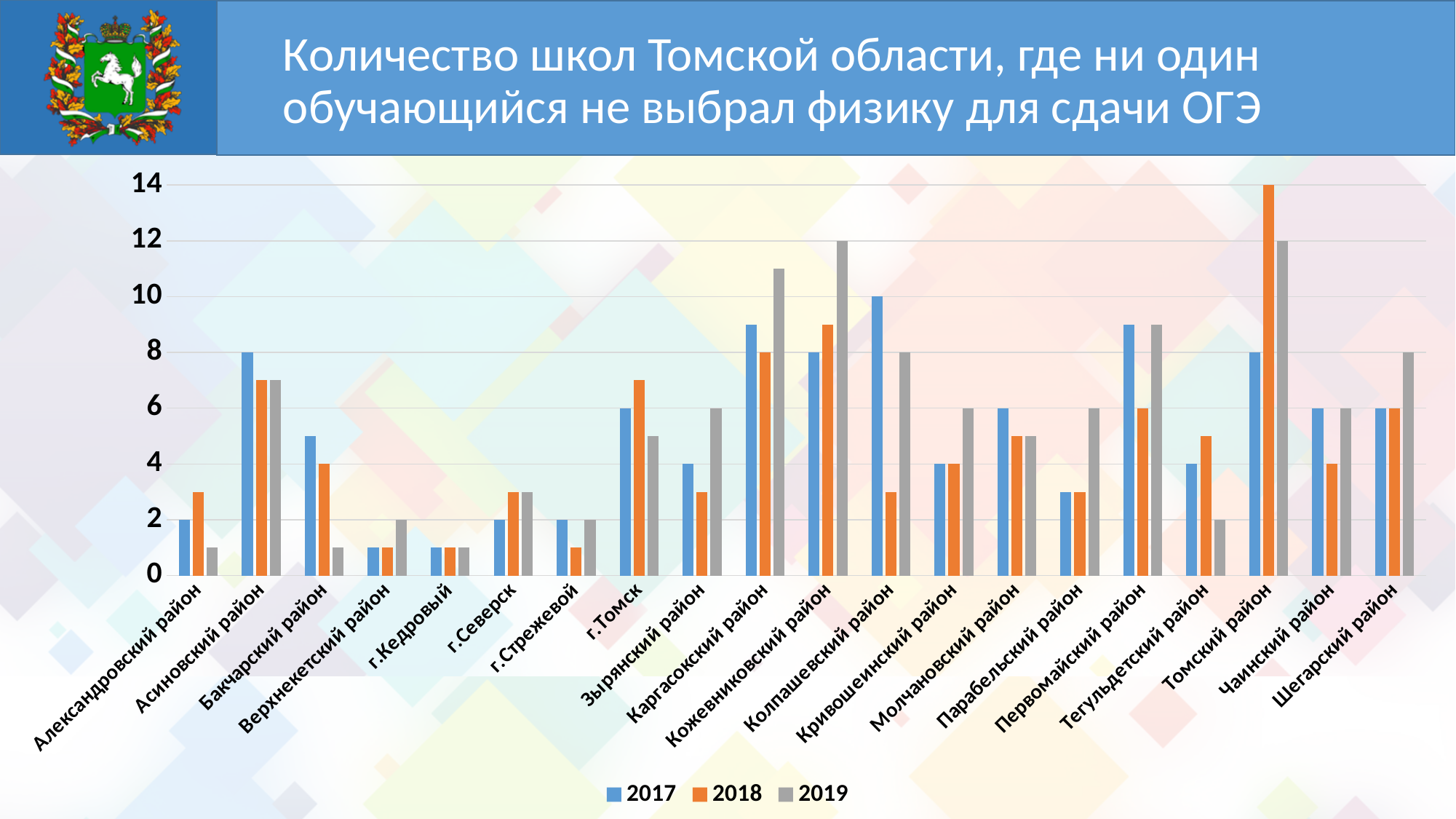
How many districts (categories) are shown on the x axis? 20 What is the value for Томский район in 2018? 14 For Колпашевский район, which year has the larger value, 2017 or 2018? 2017 Do the values for Кожевниковский район rise or fall from 2017 to 2019? rise What kind of chart is shown on the slide? bar chart What are the legend entries of the chart? 2017, 2018, 2019 What is the value for Кожевниковский район in 2019? 12 Which district has the highest value in 2018? Томский район What is the value for Колпашевский район in 2017? 10 What is the difference between the 2018 and 2017 values for Томский район? 6 Is the value for Каргасокский район in 2019 greater or less than 10? greater How many series does the legend list? 3